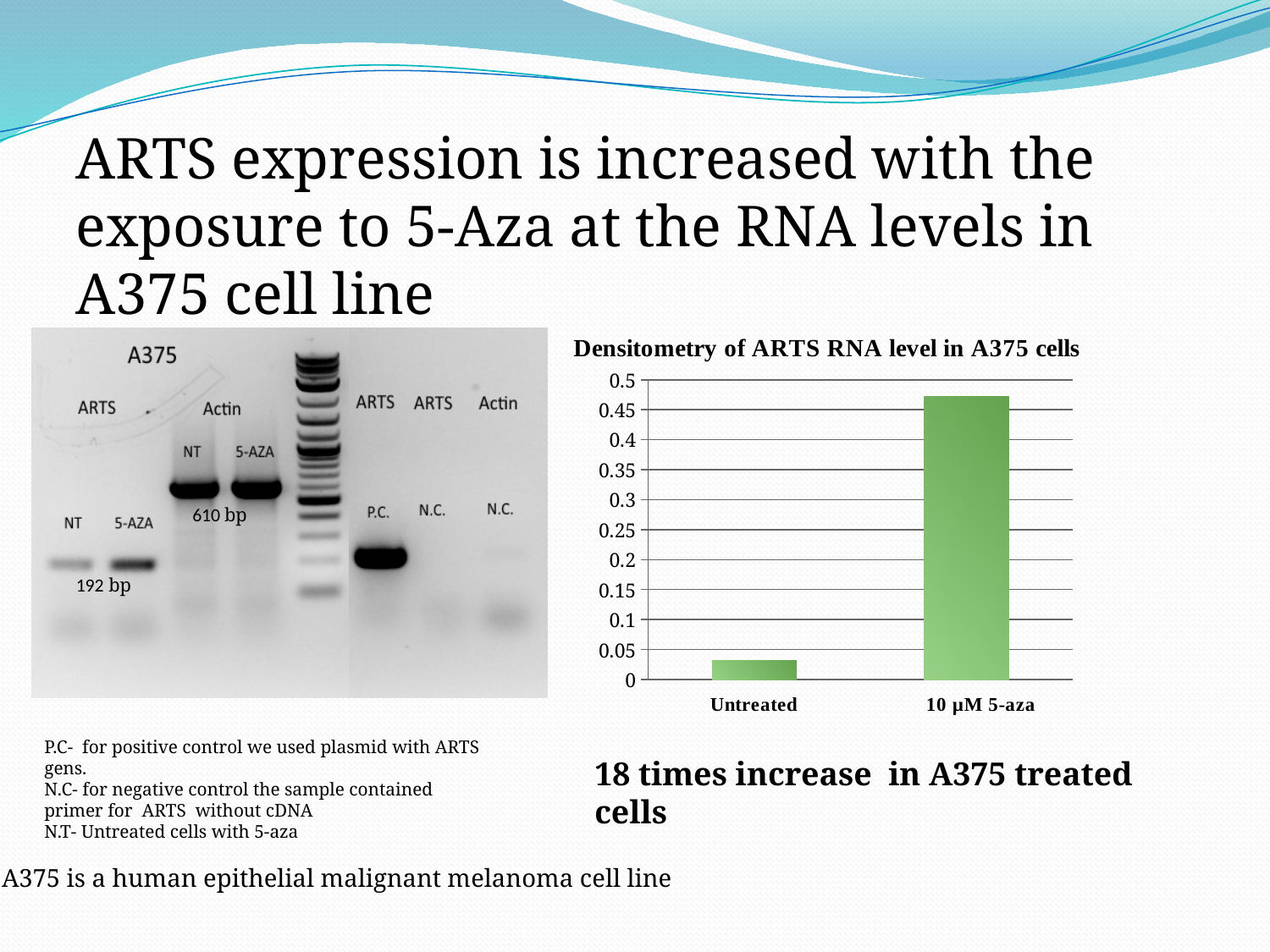
Is the value for 10 µM 5-aza greater or less than 0.4? greater What kind of chart is shown on the slide? bar chart Do the values rise or fall from Untreated to 10 µM 5-aza along the x axis? rise Which is larger, the value for Untreated or the value for 10 µM 5-aza? 10 µM 5-aza Which category has the highest bar in the chart? 10 µM 5-aza Is the value for Untreated greater or less than 0.05? less What is the maximum value shown on the y axis of the chart? 0.5 Which category has the lowest bar in the chart? Untreated How many categories are plotted on the x axis of the chart? 2 What is the title of the chart? Densitometry of ARTS RNA level in A375 cells Is the value for 10 µM 5-aza greater or less than 0.5? less